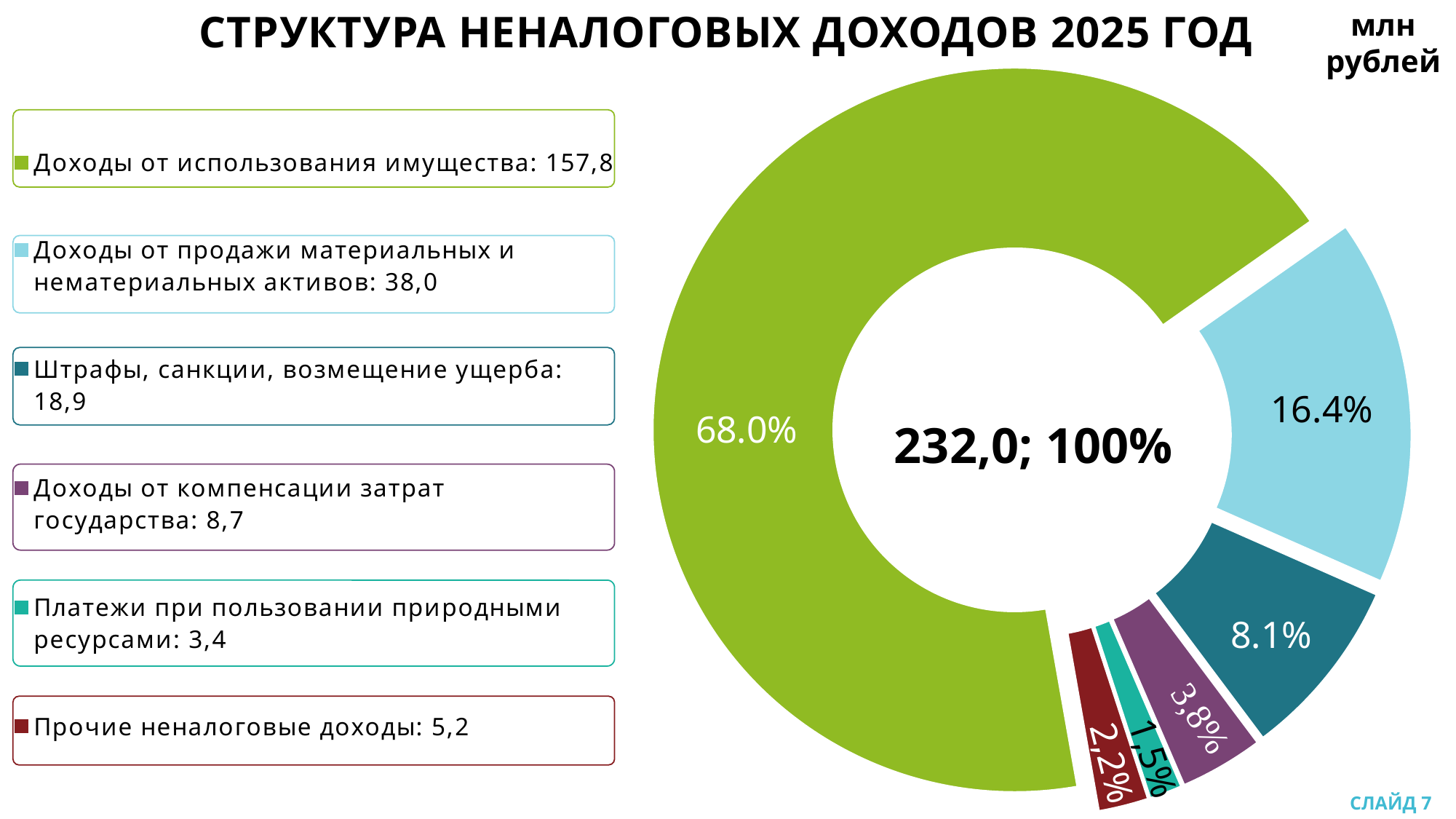
How many categories does the chart show? 6 What is the value for «Доходы от использования имущества»? 157,8 Which category has the smallest value? Платежи при пользовании природными ресурсами What share of the chart does «Доходы от продажи материальных и нематериальных активов» take? 16.4% Which category has the largest value? Доходы от использования имущества Which is larger: «Прочие неналоговые доходы» or «Доходы от компенсации затрат государства»? Доходы от компенсации затрат государства What share of the chart does «Доходы от компенсации затрат государства» take? 3,8% What is the value for «Платежи при пользовании природными ресурсами»? 3,4 What total value is shown in the centre of the chart? 232,0 What is the difference between the values for «Доходы от продажи материальных и нематериальных активов» and «Штрафы, санкции, возмещение ущерба»? 19,1 What is the value for «Штрафы, санкции, возмещение ущерба»? 18,9 What kind of chart is shown on the slide? Pie (donut) chart